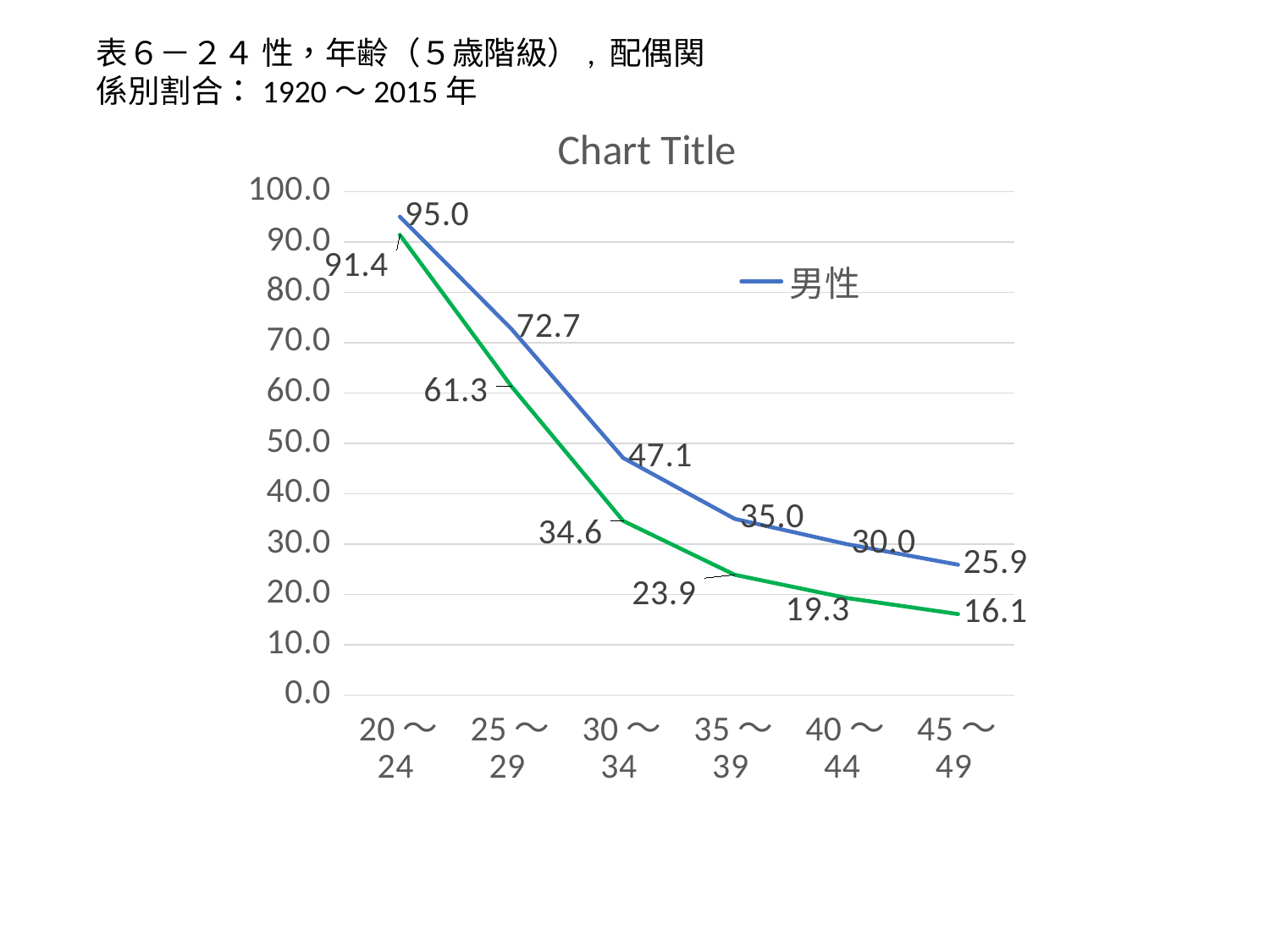
Do the 男性 values rise or fall as age increases along the x axis? fall How much higher is the 男性 value for 20〜24 than for 25〜29? 22.3 In which age group is the 男性 value highest? 20〜24 What is the value for 男性 in the 20〜24 age group? 95.0 How many series does the legend list? 1 What is the value for 男性 in the 45〜49 age group? 25.9 How many age groups are shown on the x axis? 6 In the 35〜39 age group, which is larger: the 男性 value or the green line's value? 男性 What is the value of the green line in the 30〜34 age group? 34.6 In which age group is the green line's value lowest? 45〜49 In the 30〜34 age group, what is the difference between the 男性 value and the green line's value? 12.5 Is the 男性 value for 25〜29 greater or less than 70.0? greater